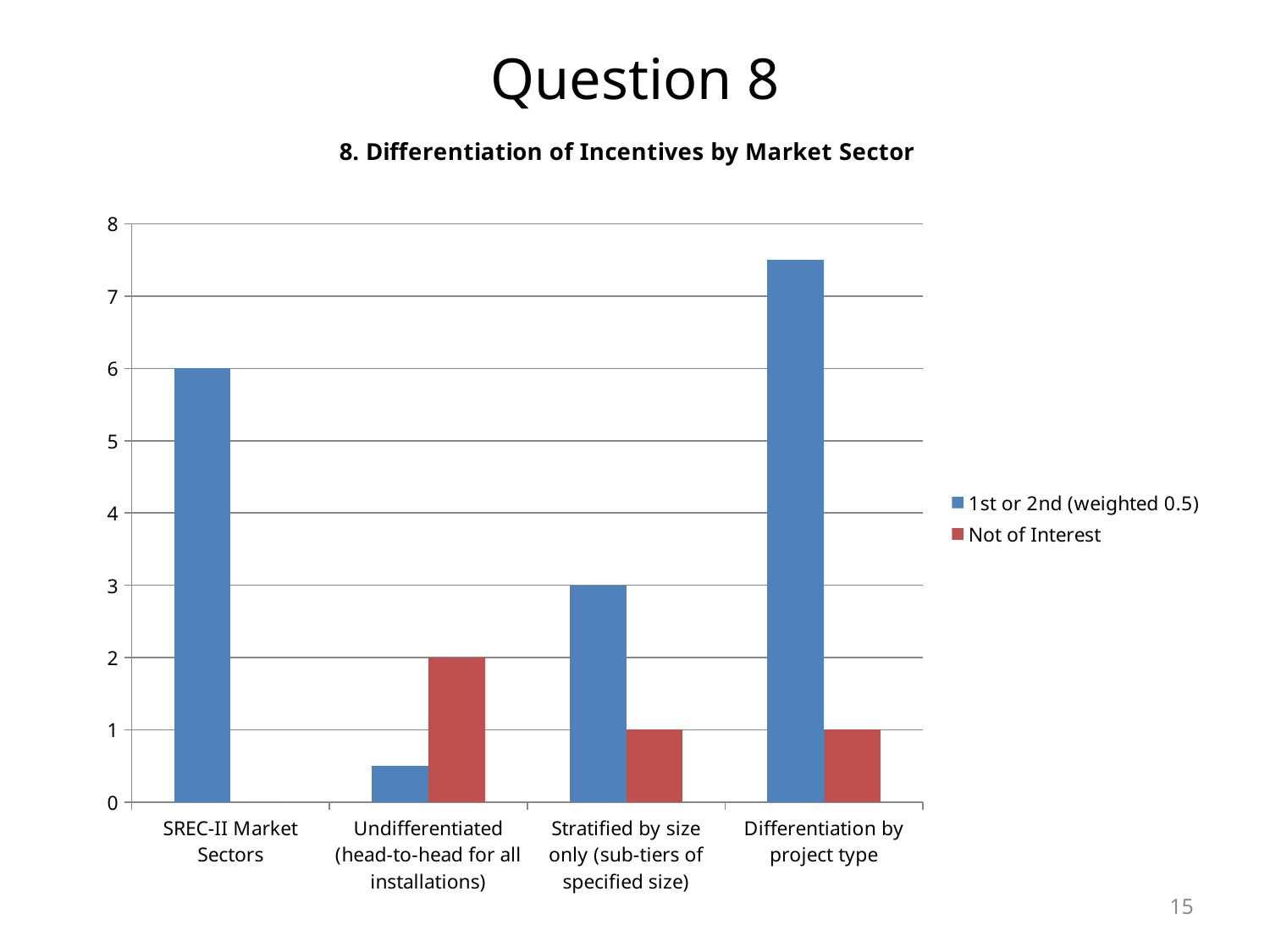
How many series does the legend list? 2 Is the '1st or 2nd (weighted 0.5)' value for 'Undifferentiated (head-to-head for all installations)' greater or less than 1? less Is the '1st or 2nd (weighted 0.5)' value for 'Differentiation by project type' greater or less than 7? greater Which category has the highest '1st or 2nd (weighted 0.5)' value? Differentiation by project type What is the value of '1st or 2nd (weighted 0.5)' for SREC-II Market Sectors? 6 Which category has the highest 'Not of Interest' value? Undifferentiated (head-to-head for all installations) What kind of chart is shown on the slide? Bar chart What is the 'Not of Interest' value for 'Undifferentiated (head-to-head for all installations)'? 2 What is the difference between the '1st or 2nd (weighted 0.5)' values for SREC-II Market Sectors and 'Stratified by size only'? 3 How many categories are shown on the x axis? 4 For 'Stratified by size only', which is larger: the '1st or 2nd (weighted 0.5)' value or the 'Not of Interest' value? 1st or 2nd (weighted 0.5) What is the value of '1st or 2nd (weighted 0.5)' for 'Stratified by size only (sub-tiers of specified size)'? 3